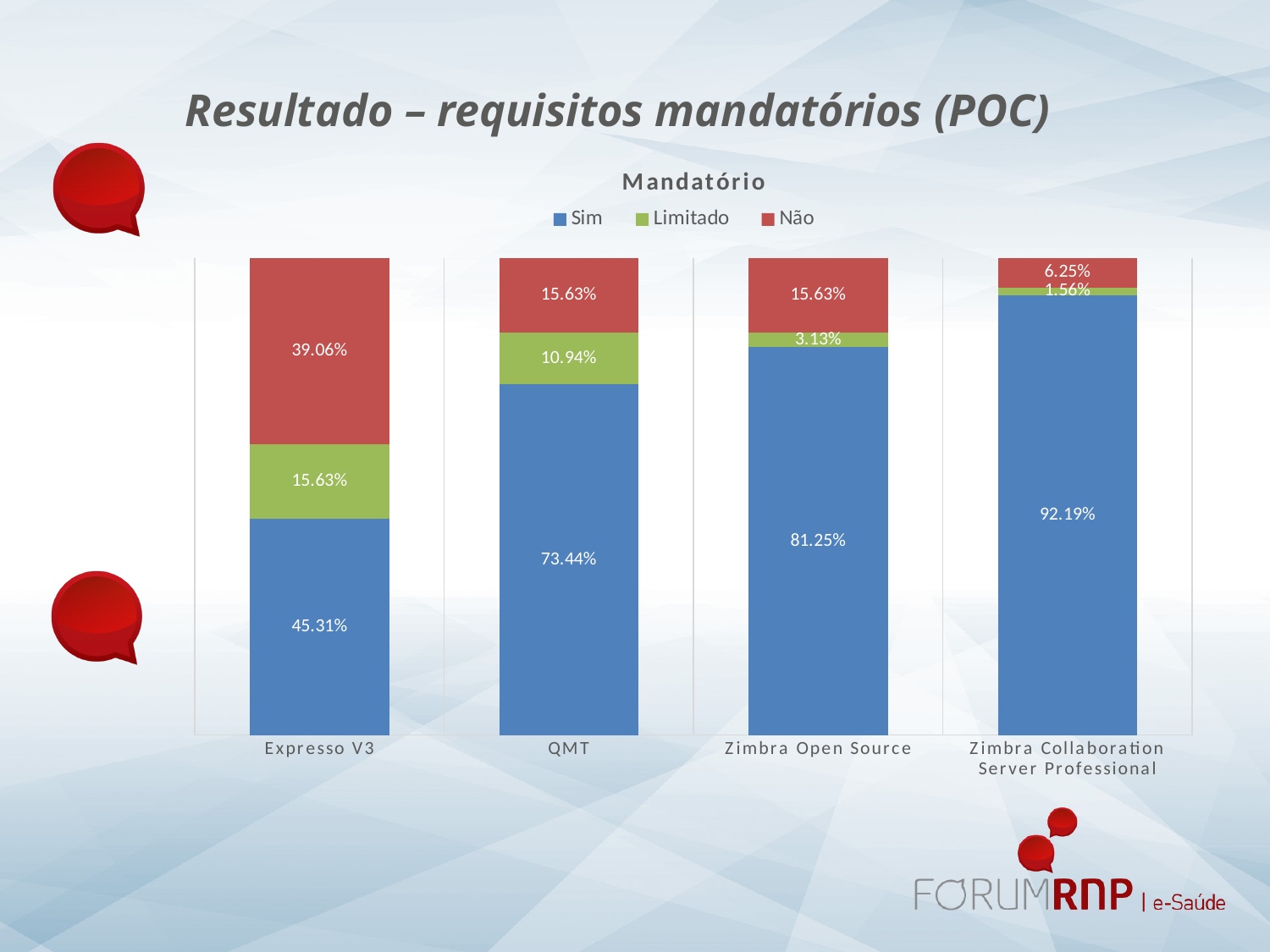
How many categories are shown on the x axis? 4 Which category has the lowest 'Sim' value? Expresso V3 What is the 'Limitado' value for Zimbra Open Source? 3.13% What is the difference between the 'Sim' values for QMT and Expresso V3? 28.13% Which is larger: the 'Não' value for Expresso V3 or the 'Não' value for Zimbra Open Source? Expresso V3 How many series does the legend list? 3 Which category has the highest 'Sim' value? Zimbra Collaboration Server Professional What is the title of the chart? Mandatório What is the 'Sim' value for Expresso V3? 45.31% What is the 'Não' value for QMT? 15.63% What is the 'Sim' value for Zimbra Collaboration Server Professional? 92.19% What kind of chart is shown on the slide? Stacked bar chart